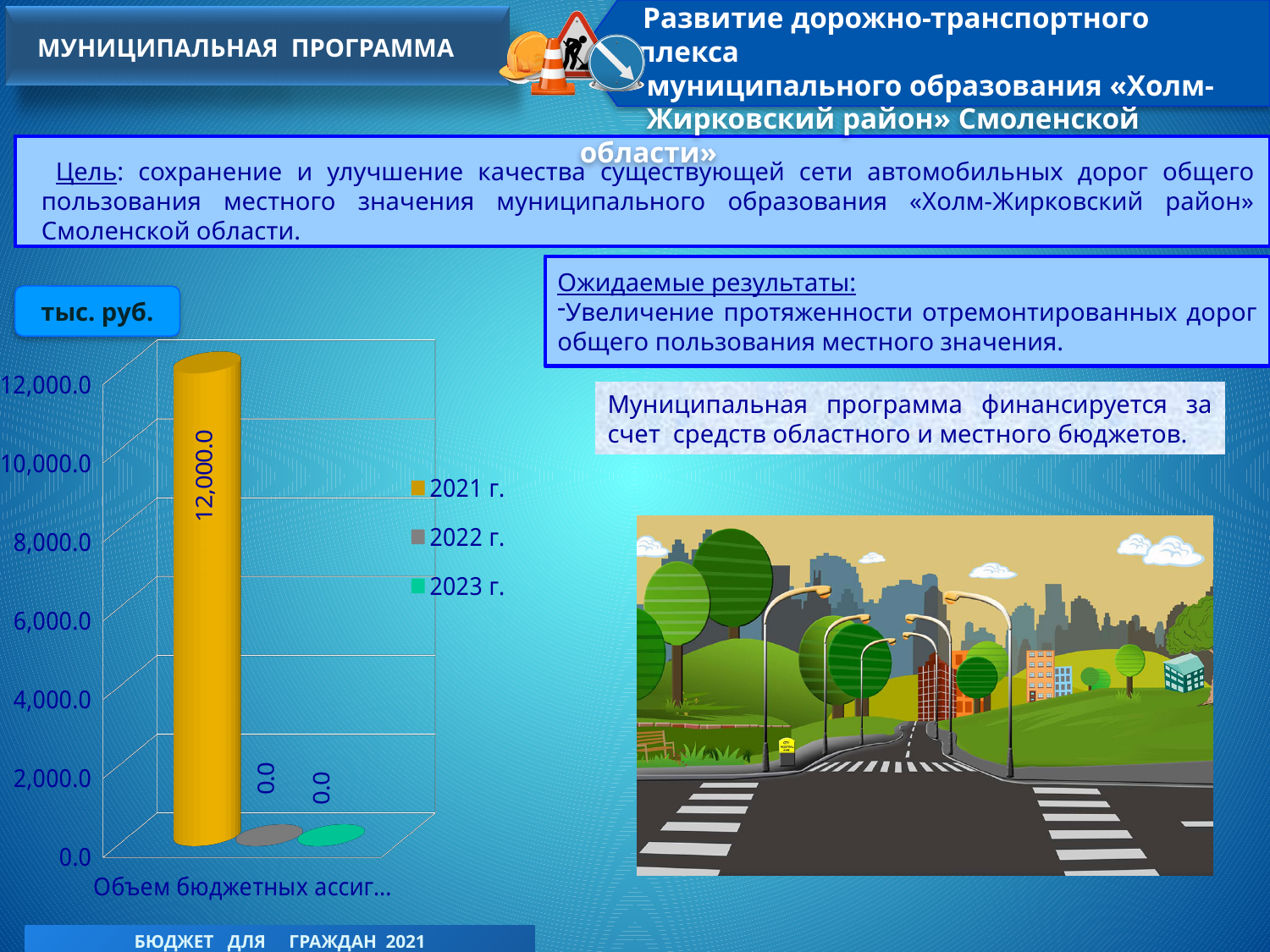
Is the value for 2021 г. greater or less than 10,000.0? greater How many series does the chart legend list? 3 Which year has the highest value in the chart? 2021 г. Which is larger, the value for 2021 г. or the value for 2023 г.? 2021 г. What is the value for 2023 г. in the chart? 0.0 What is the difference between the values for 2021 г. and 2022 г.? 12,000.0 What unit is indicated for the chart values? тыс. руб. What colour is the bar for 2021 г. in the chart? yellow What kind of chart is shown on the slide? bar chart What is the value for 2021 г. in the chart? 12,000.0 What is the value for 2022 г. in the chart? 0.0 What is the total of the values for 2021 г., 2022 г. and 2023 г.? 12,000.0